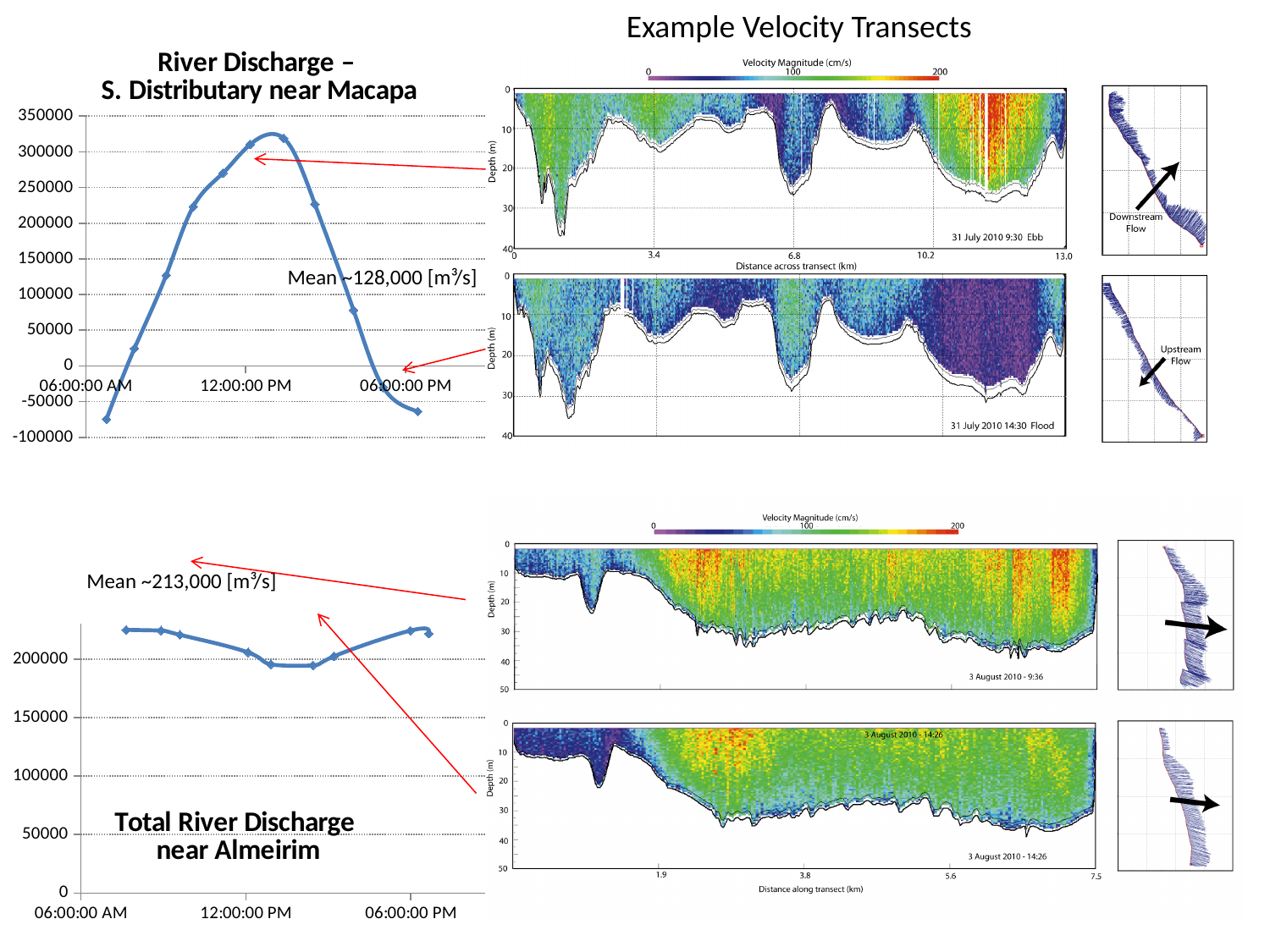
What mean discharge is annotated on the 'River Discharge – S. Distributary near Macapa' chart? ~128,000 [m³/s] On the 'River Discharge – S. Distributary near Macapa' chart, is the highest plotted value greater or less than 350000? less On the 'River Discharge – S. Distributary near Macapa' chart, is the highest plotted value greater or less than 300000? greater On the 'River Discharge – S. Distributary near Macapa' chart, which is larger: the value at 12:00:00 PM or the value at 06:00:00 PM? 12:00:00 PM On the 'River Discharge – S. Distributary near Macapa' chart, do the values rise or fall between 12:00:00 PM and 06:00:00 PM? fall On the 'Total River Discharge near Almeirim' chart, is the lowest plotted value greater or less than 150000? greater What mean discharge is annotated on the 'Total River Discharge near Almeirim' chart? ~213,000 [m³/s] On the 'River Discharge – S. Distributary near Macapa' chart, do the values rise or fall between 06:00:00 AM and 12:00:00 PM? rise What kind of chart is the 'River Discharge – S. Distributary near Macapa' chart? line chart